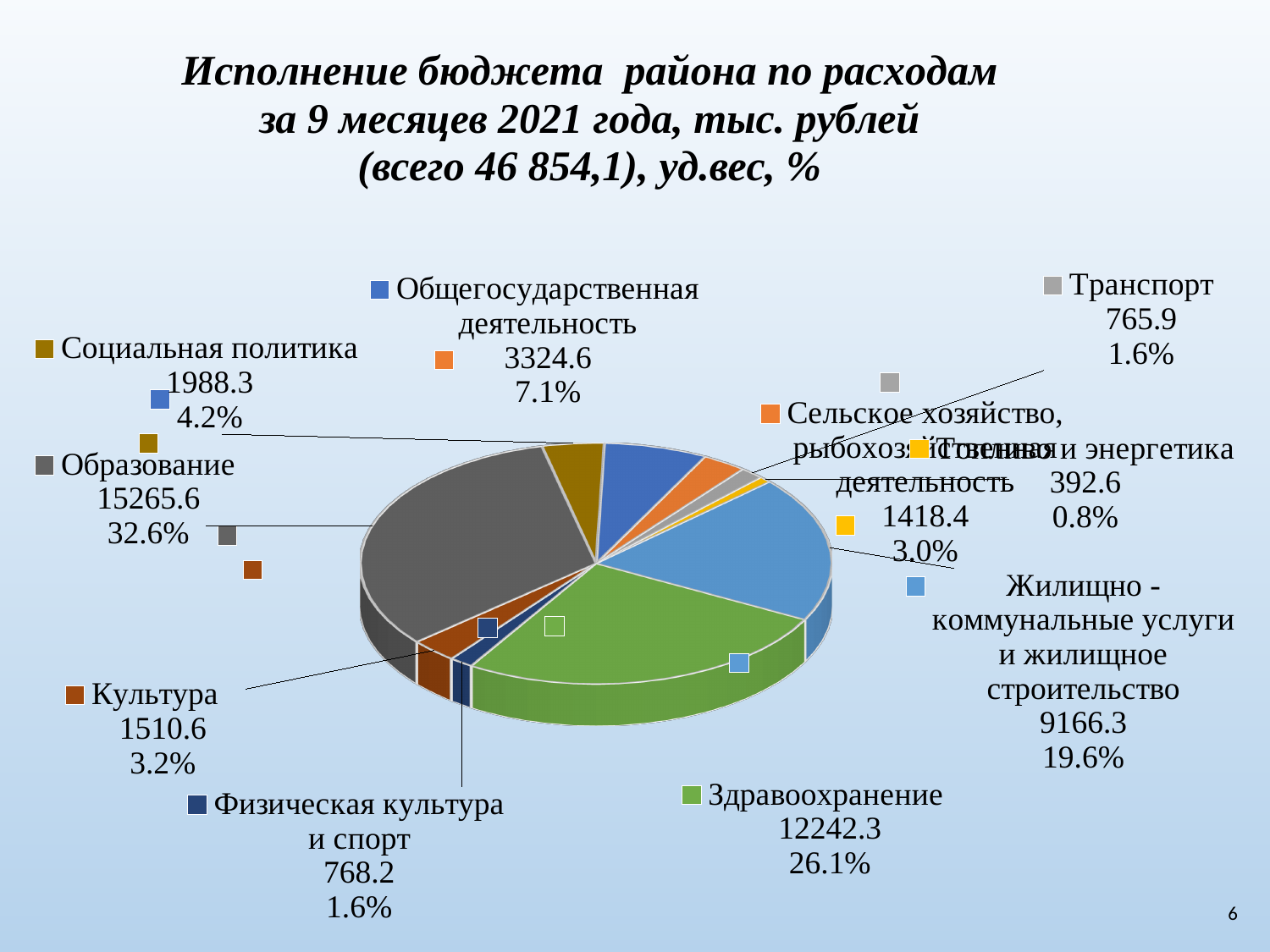
What kind of chart is shown on the slide? pie chart How many categories are shown in the pie chart? 10 What is the value for Жилищно-коммунальные услуги и жилищное строительство? 9166.3 What share of the pie does Здравоохранение represent? 26.1% Which category has the smallest slice of the pie? Топливо и энергетика What is the value for Образование? 15265.6 What share of the pie does Общегосударственная деятельность represent? 7.1% What is the difference between the values for Образование and Здравоохранение? 3023.3 Which is larger, the value for Культура or the value for Социальная политика? Социальная политика Which category has the largest slice of the pie? Образование What total is stated in the chart title? 46 854,1 What is the value for Физическая культура и спорт? 768.2